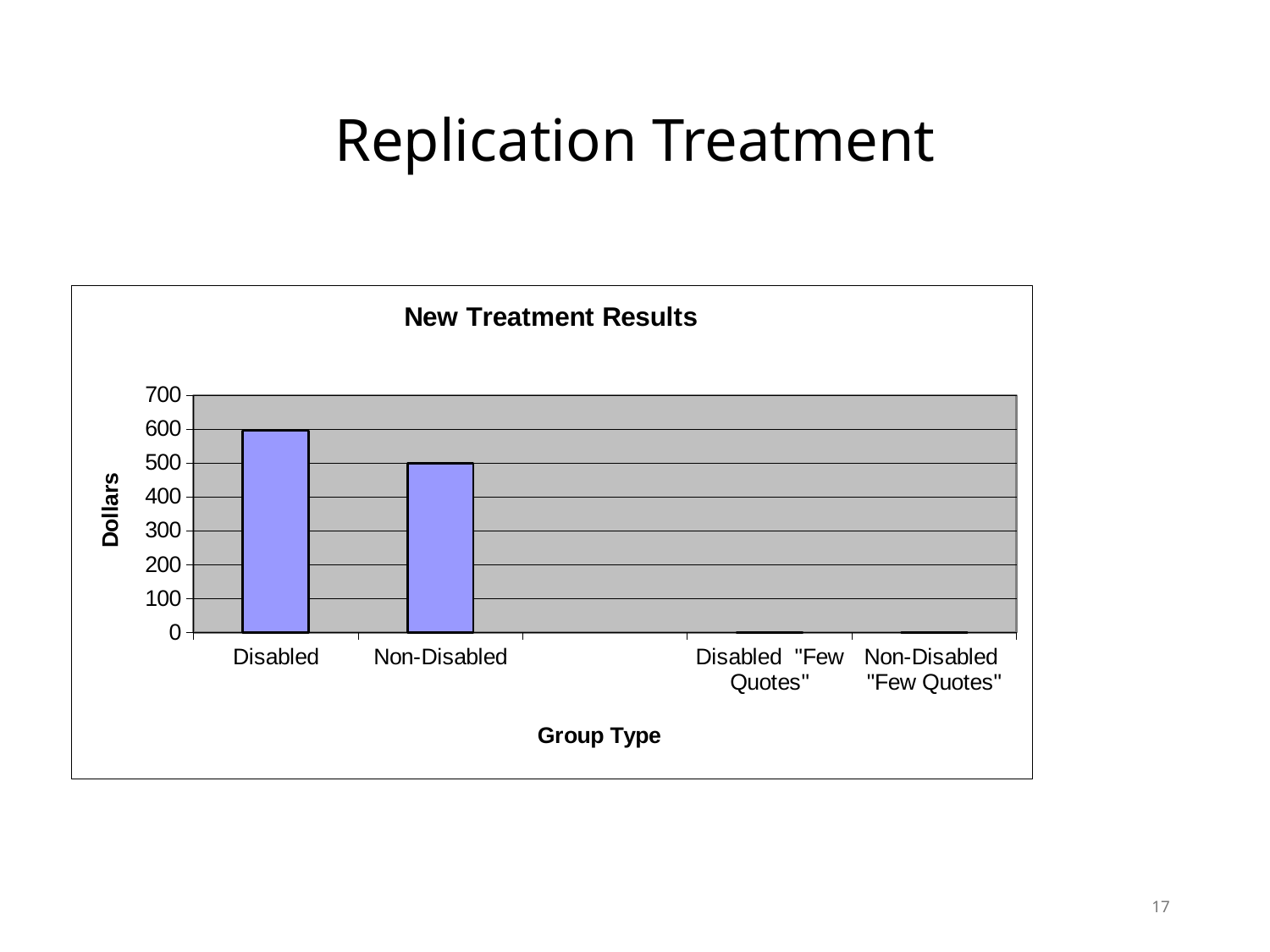
What is the title of the chart? New Treatment Results Which is larger, the value for Disabled or the value for Non-Disabled? Disabled Is the value for Non-Disabled greater or less than 600? less What is the value for Non-Disabled? 500 What type of chart is shown on the slide? bar chart Which is larger, the value for Non-Disabled or the value for Non-Disabled "Few Quotes"? Non-Disabled Which group has the highest value? Disabled How many labeled group types are shown on the x axis? 4 What is the highest value shown on the vertical axis? 700 What is the label of the vertical axis? Dollars Is the value for Disabled "Few Quotes" greater or less than 100? less Is the value for Disabled greater or less than 500? greater